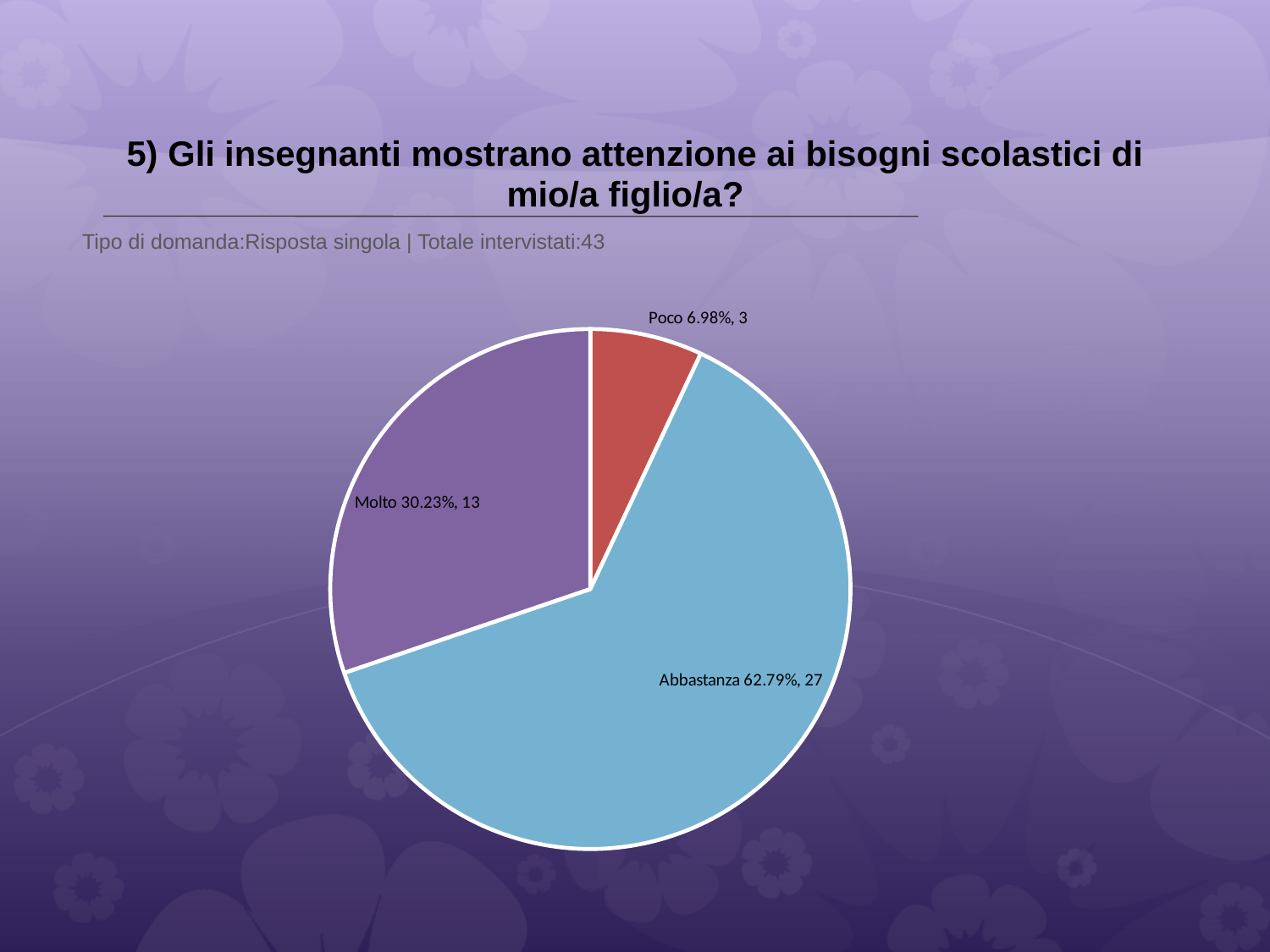
What is the difference in respondent count between Abbastanza and Molto? 14 How many respondents answered Molto? 13 Which response has the smallest slice? Poco Which response has the largest slice? Abbastanza How many slices does the pie chart have? 3 How many respondents answered Poco? 3 What percentage share does the Poco slice have? 6.98% Which has more respondents, Molto or Poco? Molto What percentage share does the Abbastanza slice have? 62.79% What is the total number of respondents across all slices? 43 What kind of chart is shown on the slide? pie chart What colour is the Abbastanza slice? light blue